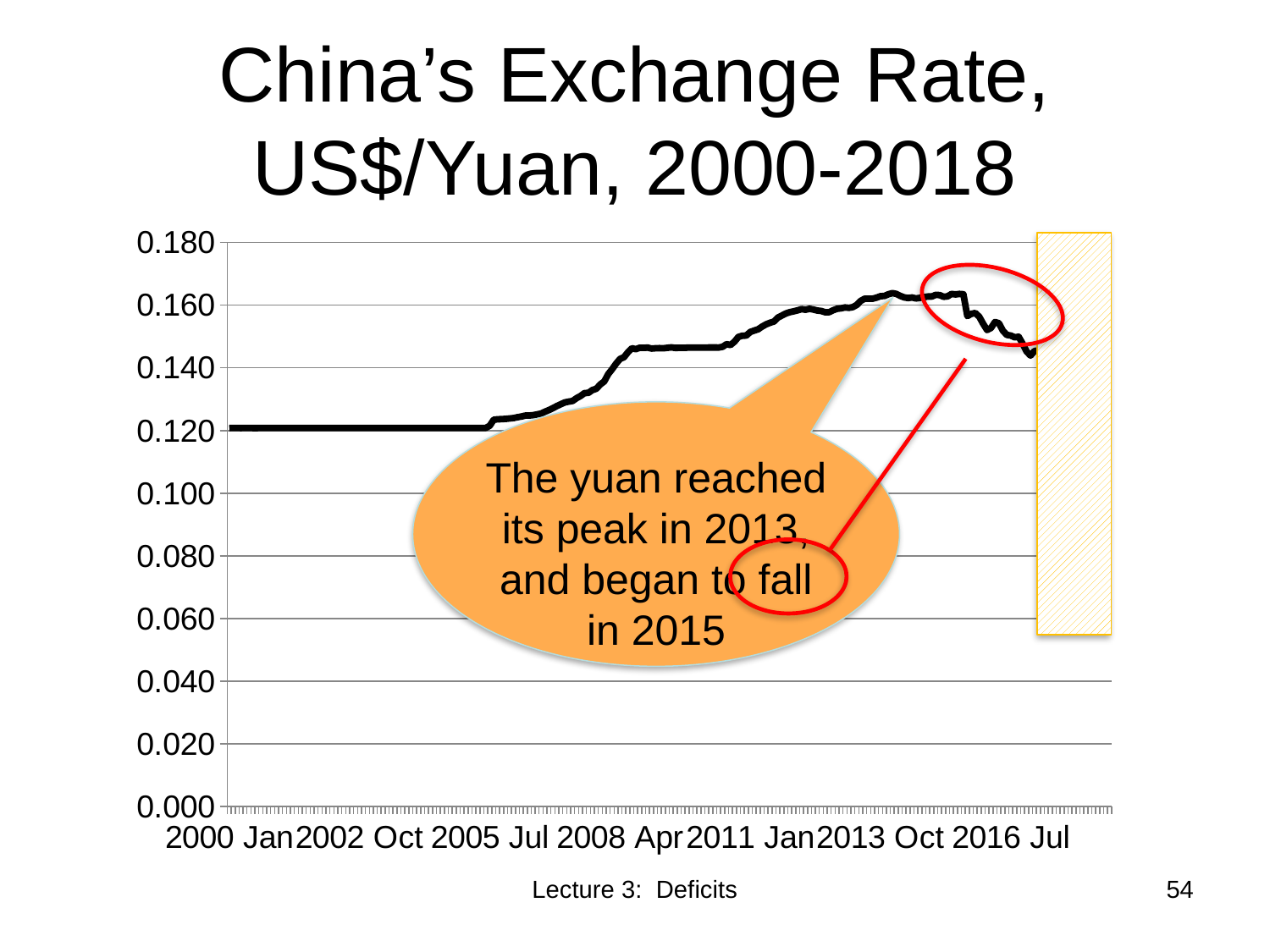
According to the annotation, in which year did the yuan reach its peak? 2013 Is the exchange rate in 2000 Jan greater or less than 0.100? greater Is the exchange rate in 2008 Apr greater or less than 0.120? greater Is the exchange rate in 2008 Apr greater or less than 0.160? less How many date labels are shown on the x axis? 7 Does the exchange rate rise or fall between 2005 Jul and 2013 Oct? rise Does the exchange rate rise or fall between 2013 Oct and 2016 Jul? fall What is the title of the chart? China's Exchange Rate, US$/Yuan, 2000-2018 Which is larger, the exchange rate in 2002 Oct or in 2011 Jan? 2011 Jan What kind of chart is shown on the slide? line chart